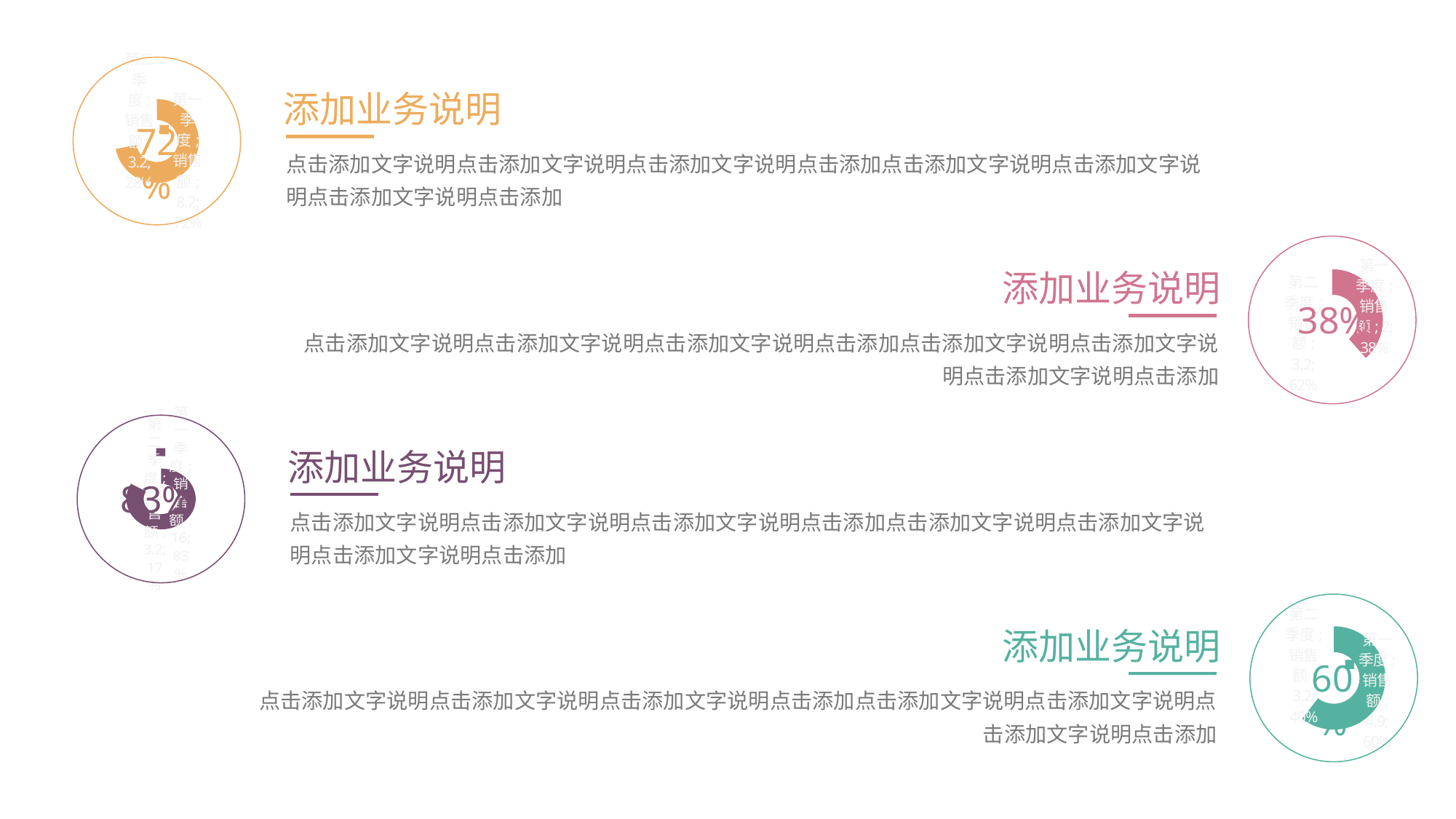
What percentage is shown in the centre of the orange doughnut chart at the top left of the slide? 72% Is the percentage shown in the pink chart greater or less than 50%? less What colour is the doughnut chart that shows 60%? Green How many doughnut charts are on the slide? 4 Which of the four doughnut charts shows the lowest central percentage? The pink chart (38%) What percentage is shown in the centre of the purple doughnut chart on the left side of the slide? 83% What kind of chart is used inside each circle on the slide? Doughnut (pie) chart What is the difference between the percentage in the purple chart and the percentage in the pink chart? 45% What percentage is shown in the centre of the pink doughnut chart on the right side of the slide? 38% What percentage is shown in the centre of the green doughnut chart at the bottom right of the slide? 60% Which is larger: the percentage in the orange chart or the percentage in the green chart? The orange chart (72%) Which of the four doughnut charts shows the highest central percentage? The purple chart (83%)